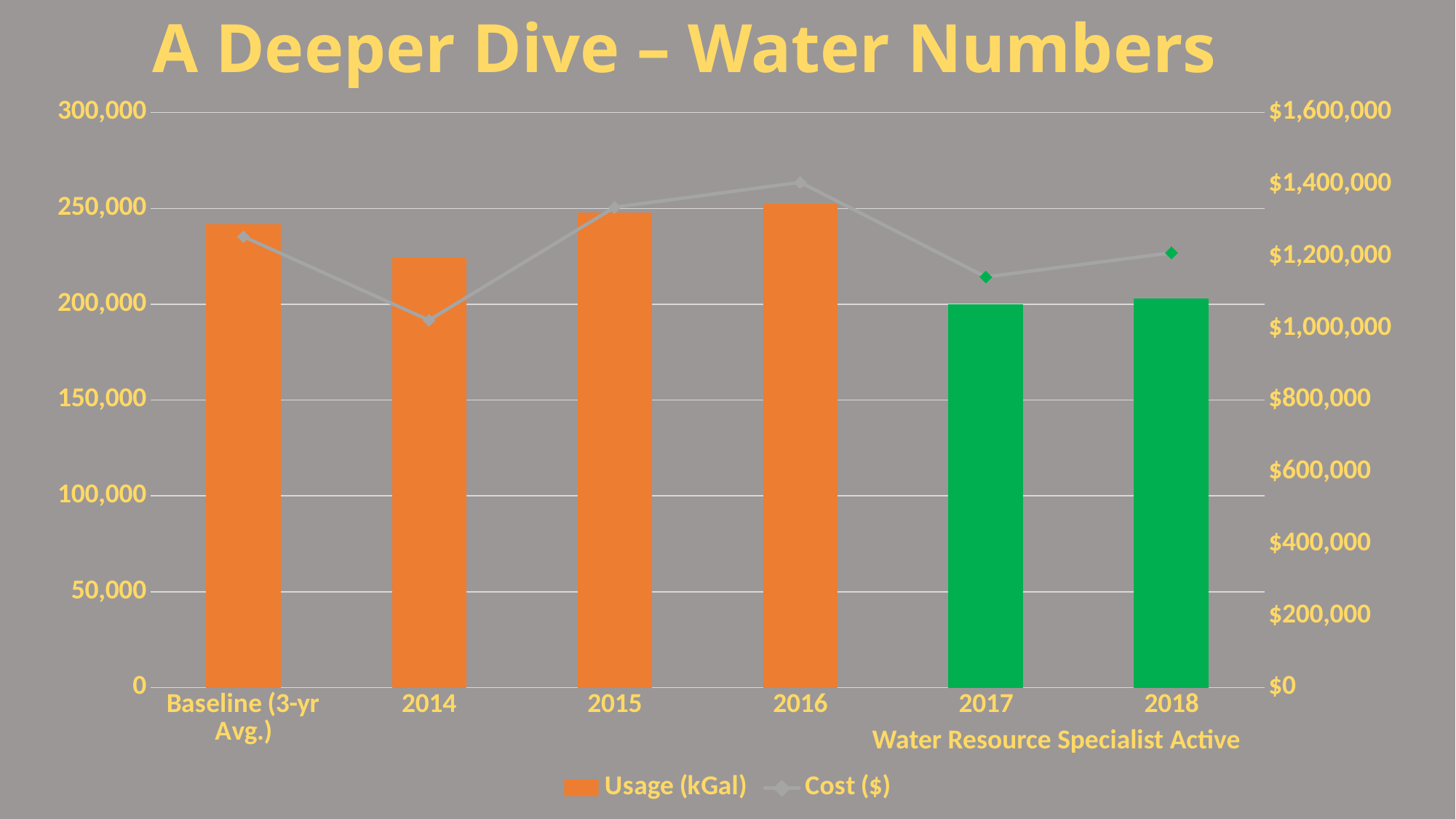
What is the title of the chart? A Deeper Dive – Water Numbers Which category has the lowest Cost ($) value? 2014 Is the Usage (kGal) value for 2014 greater or less than 250,000? less Which has the larger Usage (kGal) value, Baseline (3-yr Avg.) or 2014? Baseline (3-yr Avg.) How many series does the legend list? 2 What kind of chart is shown on the slide? Combined bar and line chart How many categories are shown along the x axis? 6 Is the Usage (kGal) value for Baseline (3-yr Avg.) greater or less than 200,000? greater Which category has the highest Cost ($) value? 2016 What text is annotated beneath the 2017 and 2018 bars? Water Resource Specialist Active Is the Cost ($) value for 2014 greater or less than $1,200,000? less Does the Cost ($) line rise or fall from 2016 to 2017? fall